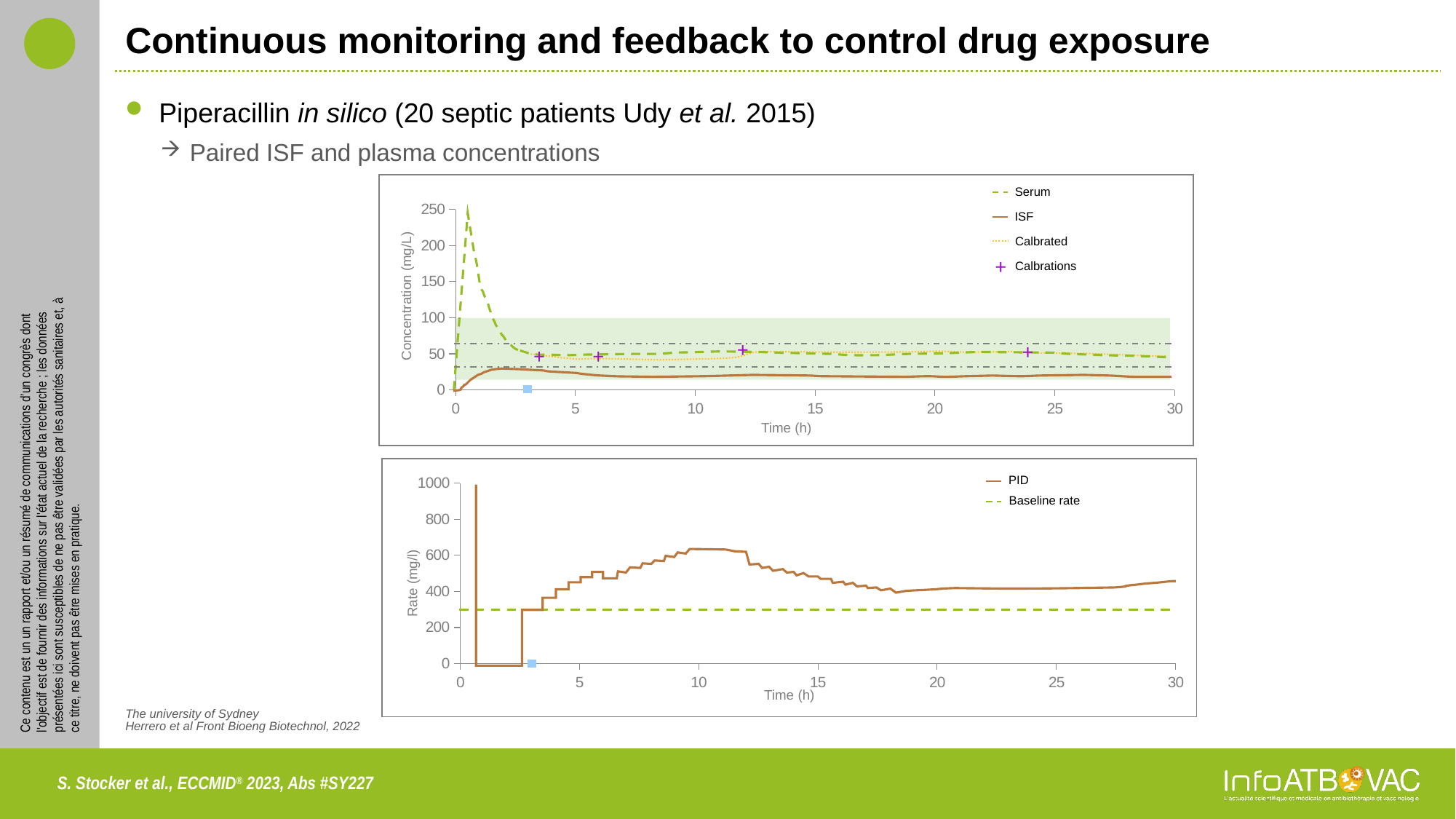
How many series does the legend of the top chart list? 4 In the top chart, is the peak Serum concentration greater or less than 200? greater In the top chart, is the ISF concentration at 30 h greater or less than 50? less What kind of chart is the top chart on the slide? line chart In the top chart, which series has the higher concentration at 30 h, Serum or ISF? Serum In the top chart, how many calibration markers (+) are plotted? 4 In the bottom chart, is the PID rate at 30 h greater or less than 400? greater What is the x-axis label of the bottom chart? Time (h) What kind of chart is the bottom chart on the slide? line chart How many series does the legend of the bottom chart list? 2 What is the y-axis label of the top chart? Concentration (mg/L)